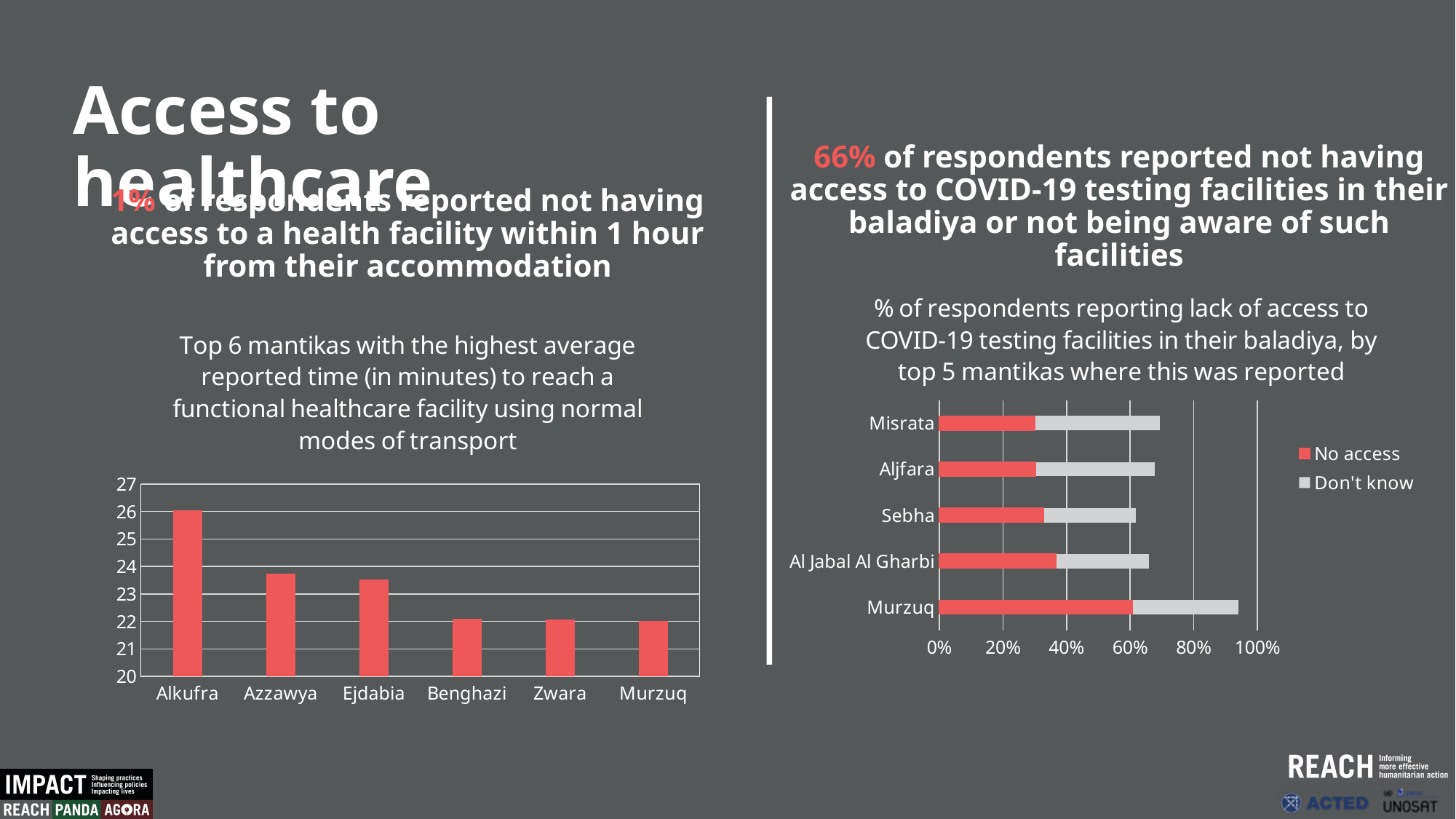
What kind of chart is the left chart? Bar chart On the right chart, how many mantikas are shown? 5 On the left chart, is the value for Benghazi greater or less than 23? less On the left chart, which mantika has the highest average reported time? Alkufra On the left chart, which is larger, the value for Alkufra or the value for Ejdabia? Alkufra On the left chart, how many mantikas are shown? 6 On the right chart, is the 'No access' value for Murzuq greater or less than 40%? greater On the right chart (% of respondents reporting lack of access to COVID-19 testing facilities), how many series does the legend list? 2 On the left chart, is the value for Azzawya greater or less than 23? greater On the left chart, do the values rise or fall from left to right along the x axis? Fall On the right chart, which mantika has the longest total bar? Murzuq